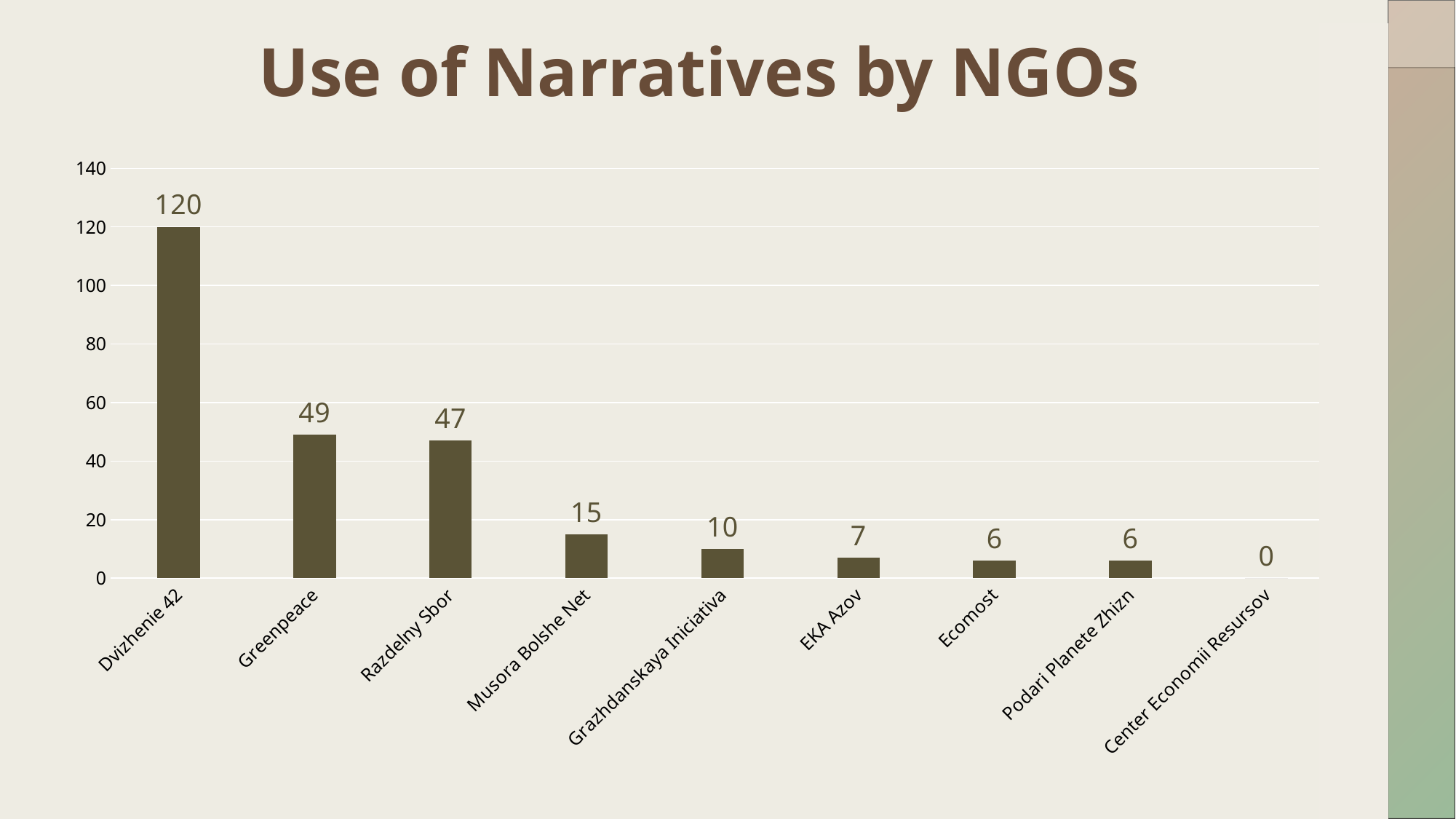
Which NGO has the highest value? Dvizhenie 42 What is the difference between the values for Razdelny Sbor and Musora Bolshe Net? 32 What is the difference between the values for Dvizhenie 42 and Greenpeace? 71 Which NGO has the lowest value? Center Economii Resursov What is the value for Dvizhenie 42? 120 What is the value for Musora Bolshe Net? 15 What is the title of the chart? Use of Narratives by NGOs What is the value for Greenpeace? 49 What kind of chart is shown on the slide? Bar chart What is the value for Center Economii Resursov? 0 How many NGOs are shown on the chart? 9 Which has a larger value, Greenpeace or Razdelny Sbor? Greenpeace